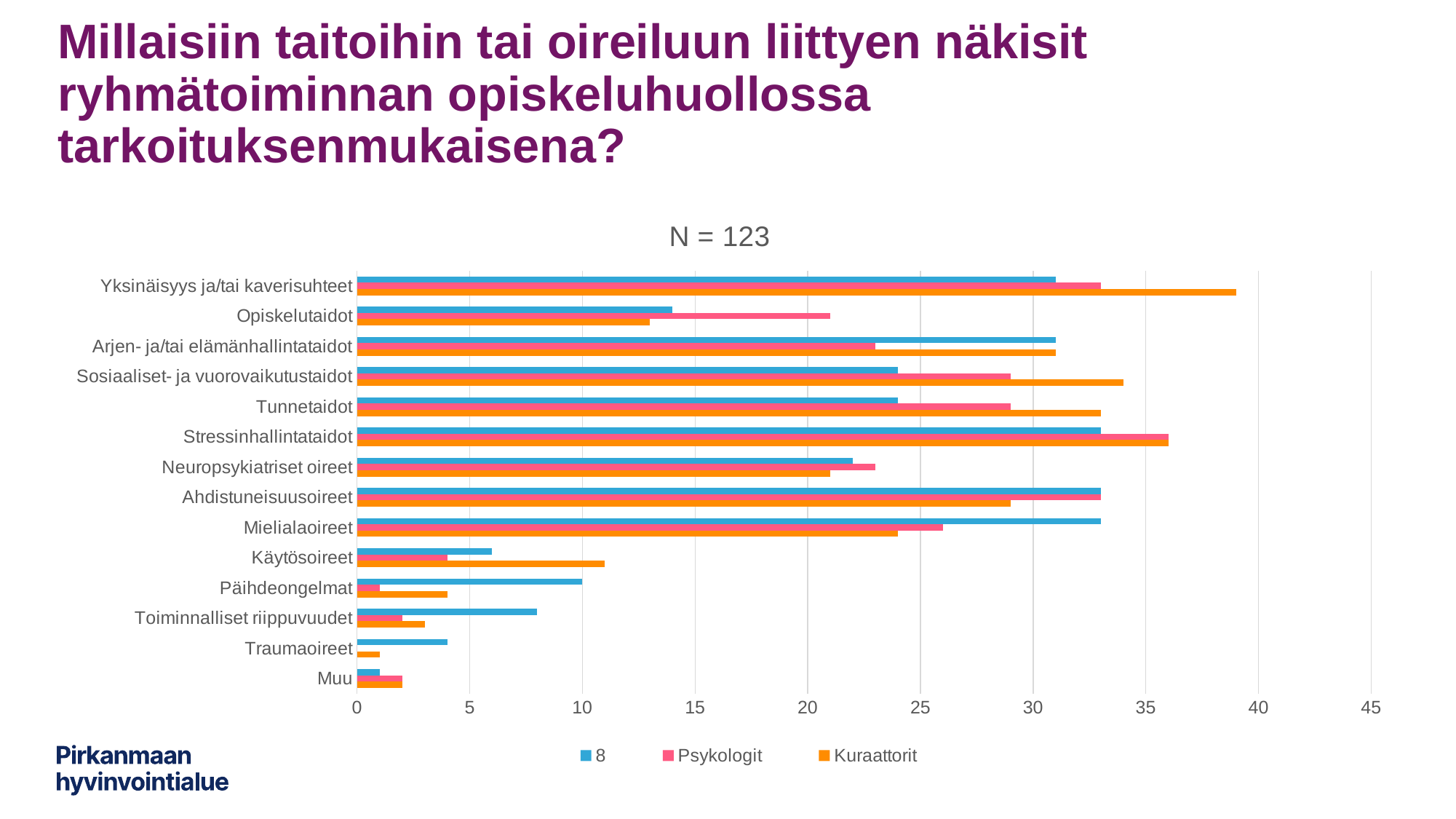
Is the value of the series labelled 8 for Opiskelutaidot greater or less than 15? less What kind of chart is shown on the slide? bar chart Which category has the lowest value for the Kuraattorit series? Traumaoireet For Yksinäisyys ja/tai kaverisuhteet, which series has the larger value: Psykologit or Kuraattorit? Kuraattorit How many categories are shown on the vertical axis of the chart? 14 What is the subtitle shown above the chart? N = 123 Is the value of the series labelled 8 for Toiminnalliset riippuvuudet greater or less than 10? less Is the Kuraattorit value for Yksinäisyys ja/tai kaverisuhteet greater or less than 35? greater Which category has the highest value for the Kuraattorit series? Yksinäisyys ja/tai kaverisuhteet Which category has the highest value for the Psykologit series? Stressinhallintataidot How many series does the legend list? 3